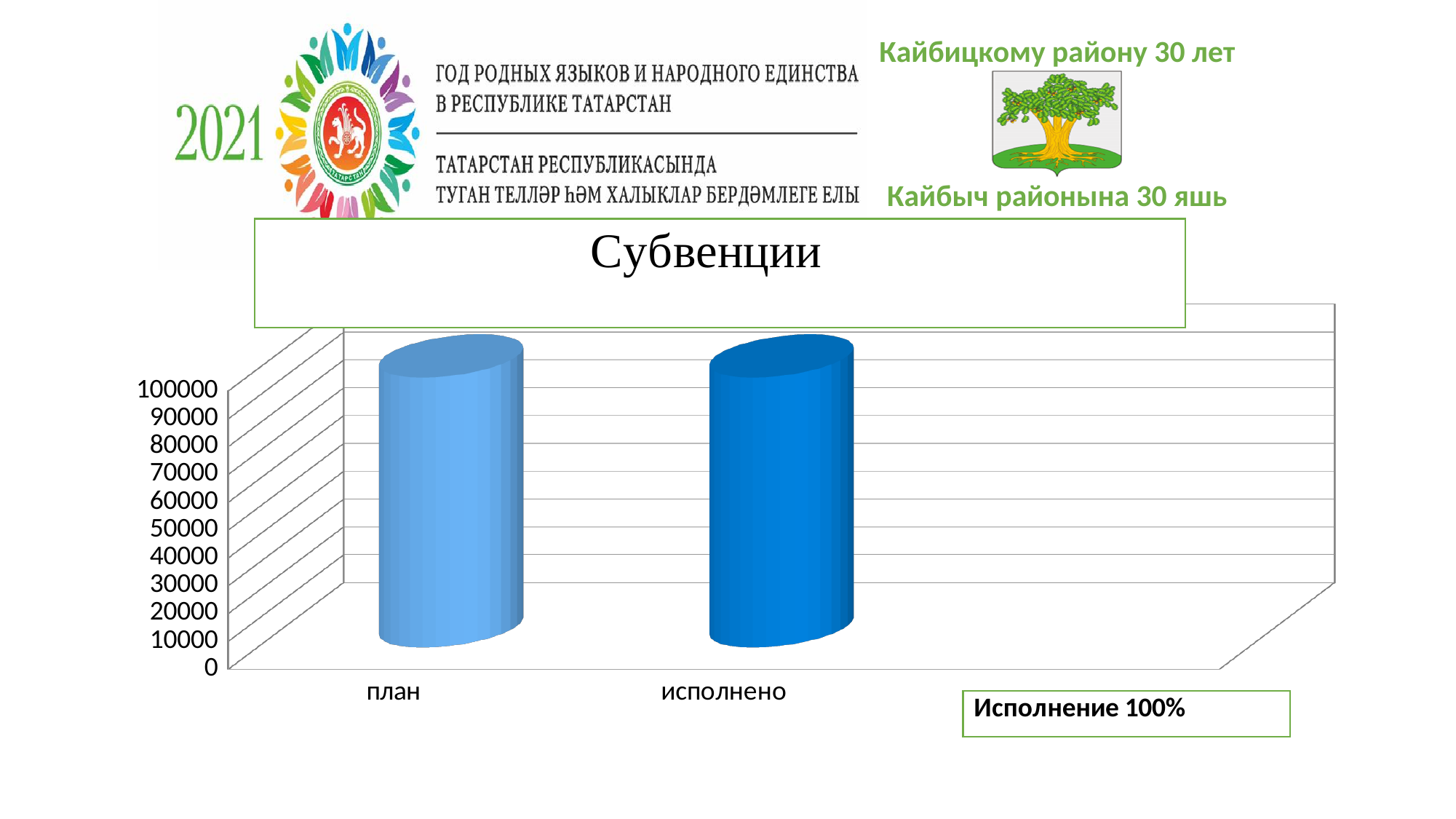
How many bars does the chart show? 2 What kind of chart is shown on the slide? bar chart What is the title of the chart? Субвенции What are the two category labels on the x axis of the chart? план, исполнено Is the value for план greater or less than 30000? greater Is the value for исполнено greater or less than 50000? greater Is the value for план greater or less than 50000? greater What is the highest tick value shown on the vertical axis of the chart? 100000